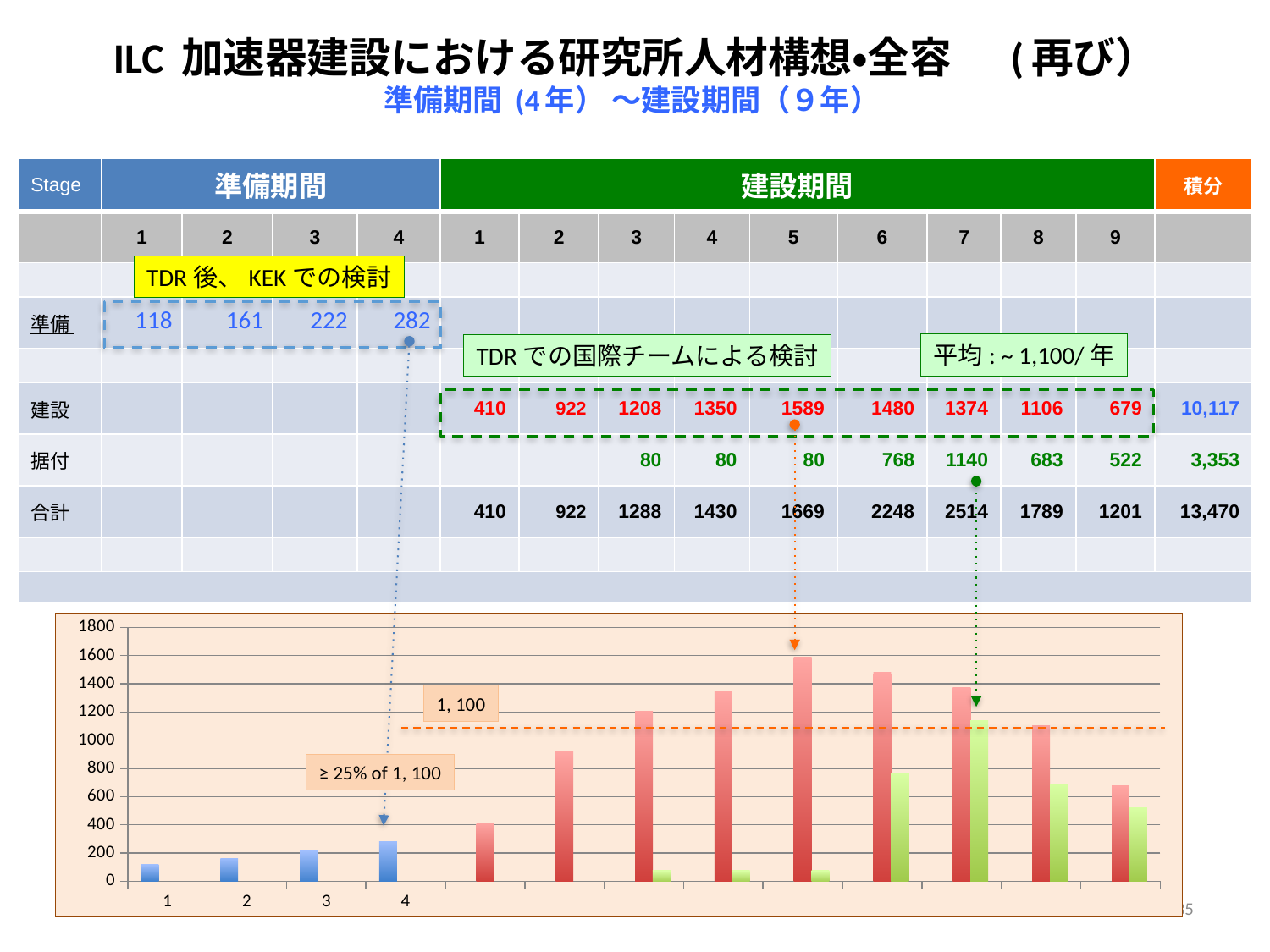
How many red bars are plotted in the chart? 9 How many blue bars are plotted in the chart? 4 Is the tallest green bar greater or less than 1000? greater Is the blue bar for category 4 greater or less than 200? greater Is the tallest red bar greater or less than 1400? greater Which of the red bars is the shortest? the first red bar What kind of chart is shown at the bottom of the slide? bar chart What does the annotation pointing at the fourth blue bar say? ≥ 25% of 1, 100 What value is the dashed horizontal line in the chart labelled with? 1, 100 Do the blue bars rise or fall from category 1 to category 4? rise Which of the red bars is the tallest? the fifth red bar